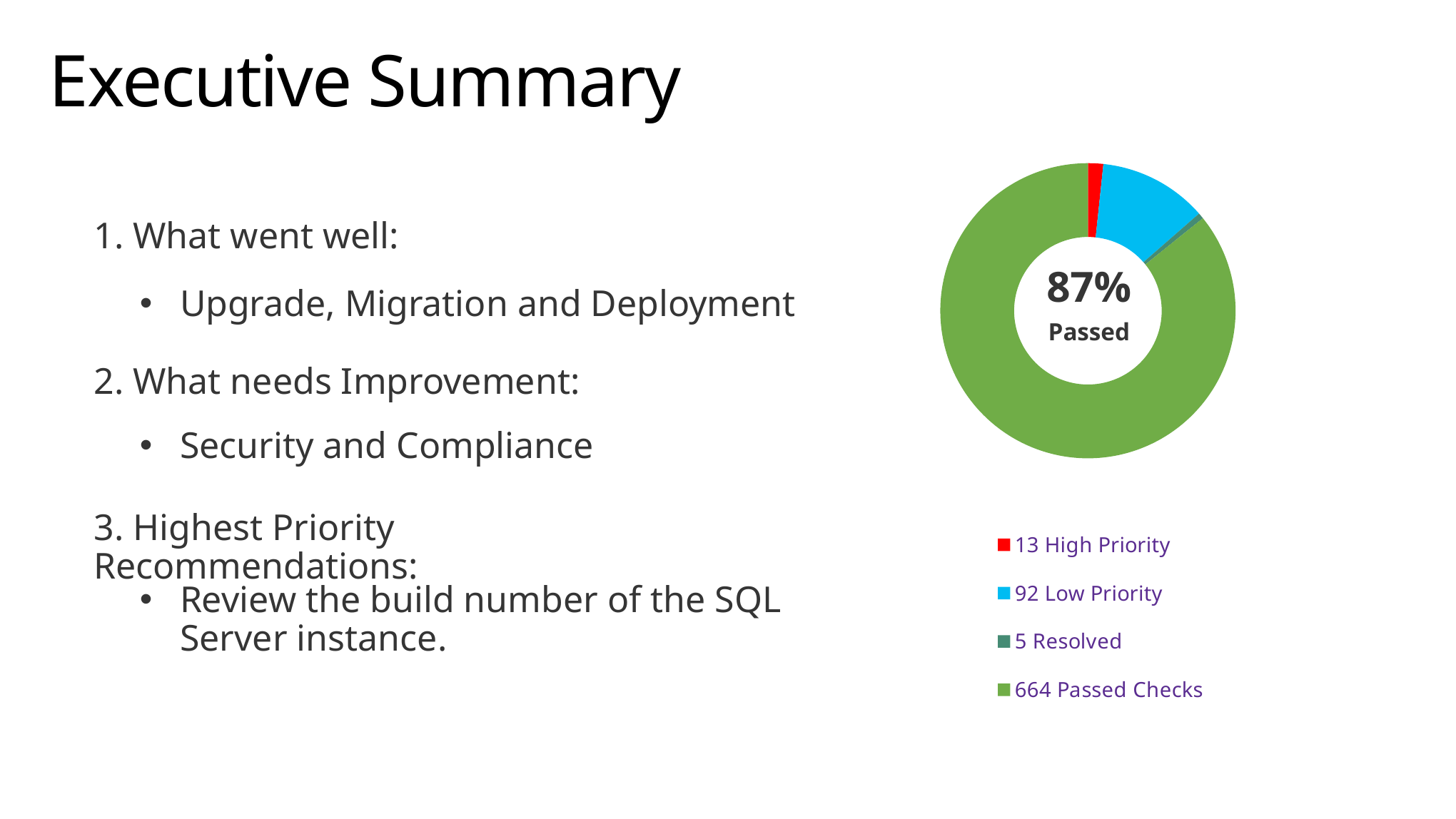
What is the difference between the Low Priority and High Priority counts? 79 How many High Priority items does the chart legend show? 13 How many Resolved items does the chart legend show? 5 Which category has the largest value in the chart? Passed Checks How many Passed Checks does the chart legend show? 664 Which category has the smallest value in the chart? Resolved How many Low Priority items does the chart legend show? 92 Which is larger, the High Priority count or the Low Priority count? Low Priority What percentage is printed in the centre of the donut chart? 87% What kind of chart is shown on the slide? pie chart (donut) How many categories does the chart legend list? 4 What colour represents Passed Checks in the chart? green